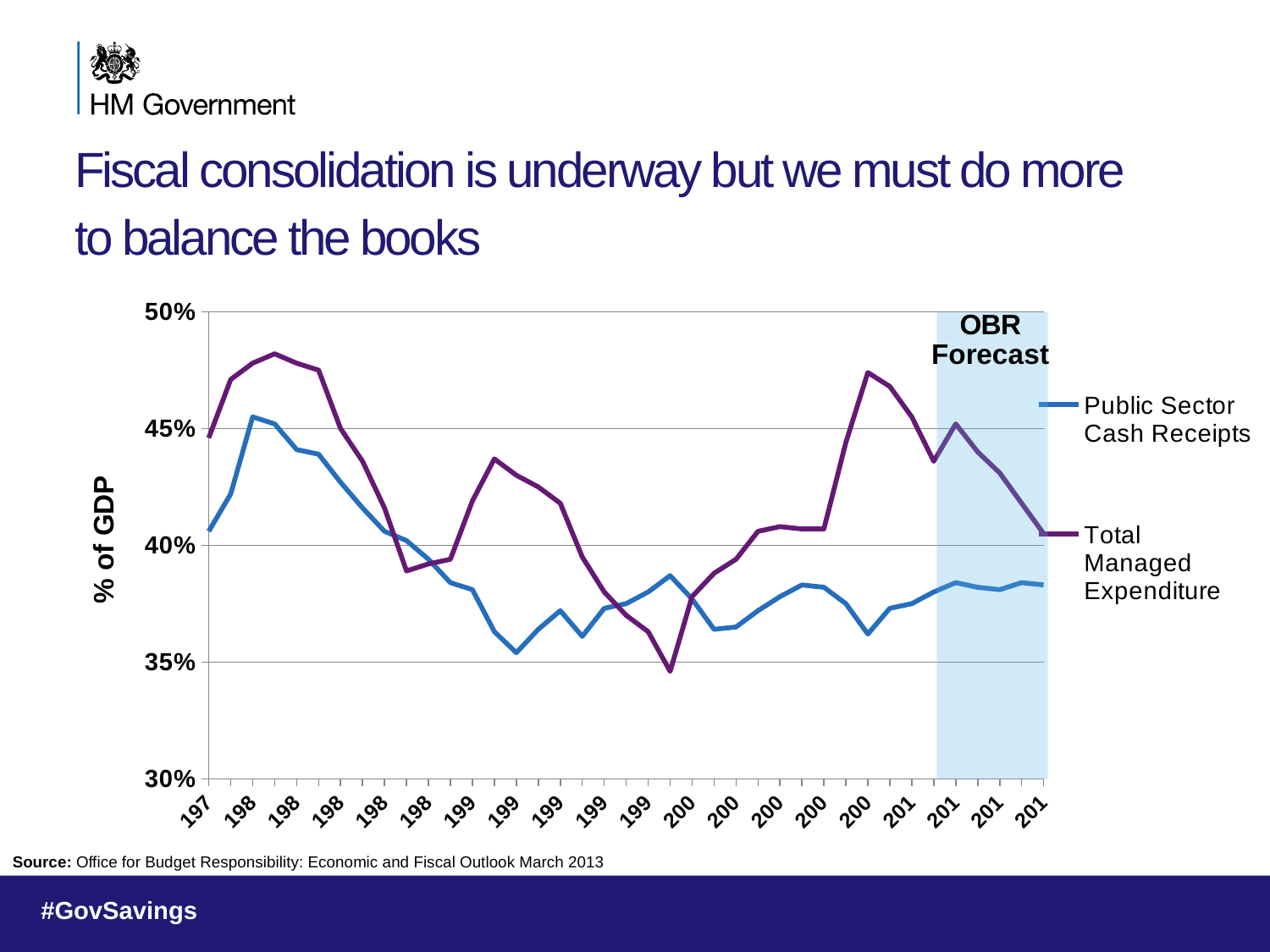
What label is shown on the shaded region at the right of the chart? OBR Forecast Is the lowest value reached by the Total Managed Expenditure line greater or less than 35%? less Is the lowest value reached by the Public Sector Cash Receipts line greater or less than 40%? less How many series does the chart's legend list? 2 At the first point on the chart, which series is higher: Public Sector Cash Receipts or Total Managed Expenditure? Total Managed Expenditure What kind of chart is shown on the slide? line chart Which series reaches the highest value anywhere on the chart? Total Managed Expenditure Over the OBR Forecast period, does the Total Managed Expenditure line end higher or lower than it starts? lower Is the highest value reached by the Public Sector Cash Receipts line greater or less than 45%? greater At the last point on the chart, which series is higher: Public Sector Cash Receipts or Total Managed Expenditure? Total Managed Expenditure What are the two series named in the chart's legend? Public Sector Cash Receipts and Total Managed Expenditure